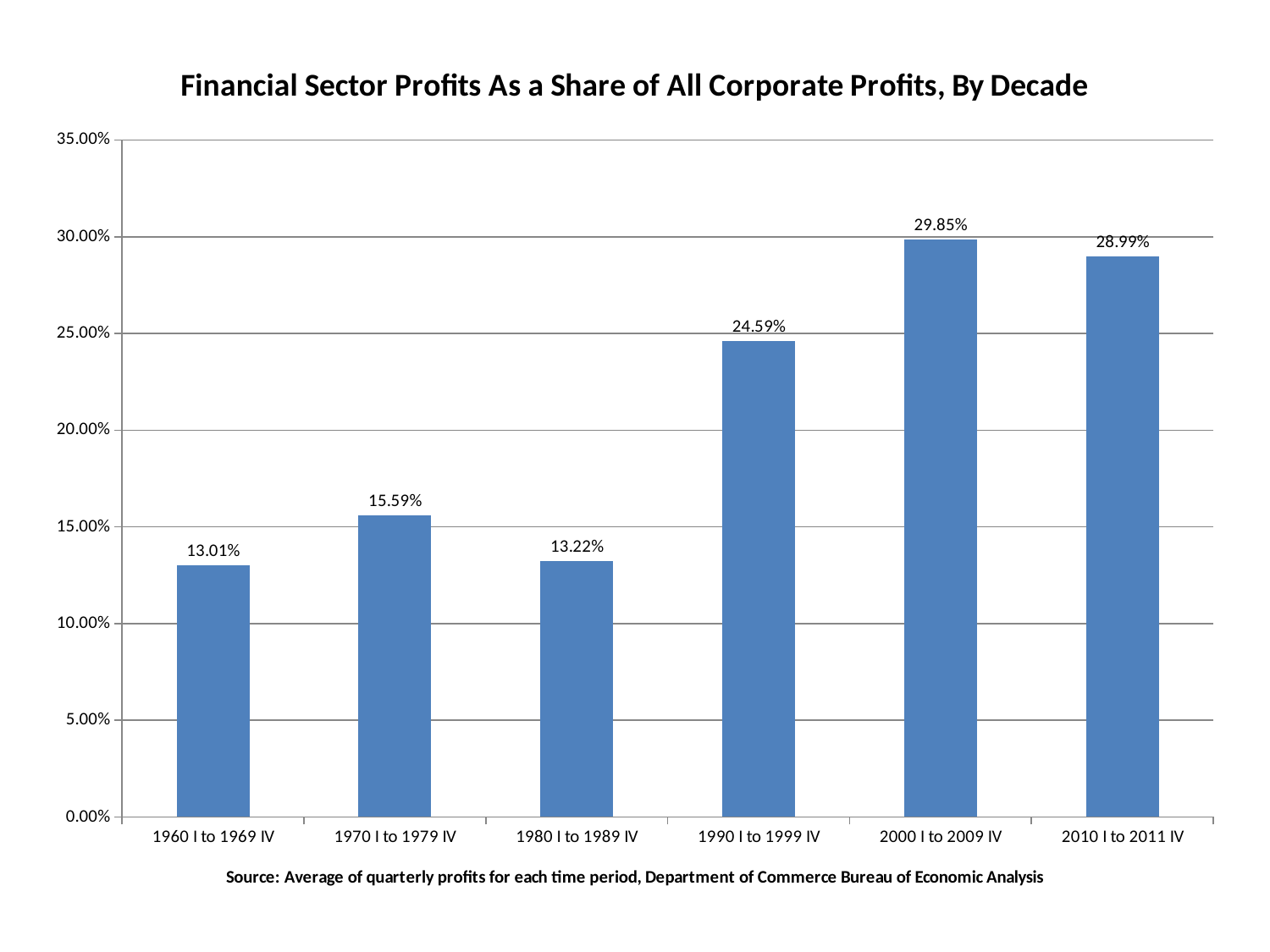
Which period has the highest value? 2000 I to 2009 IV Which period has the lowest value? 1960 I to 1969 IV What is the value for 1960 I to 1969 IV? 13.01% What is the difference between the values for 2000 I to 2009 IV and 2010 I to 2011 IV? 0.86% What is the value for 1990 I to 1999 IV? 24.59% What is the difference between the values for 1990 I to 1999 IV and 1980 I to 1989 IV? 11.37% What is the title of the chart? Financial Sector Profits As a Share of All Corporate Profits, By Decade Is the value for 2010 I to 2011 IV greater or less than 30.00%? less How many periods are shown on the chart? 6 Which is larger, the value for 1970 I to 1979 IV or the value for 1980 I to 1989 IV? 1970 I to 1979 IV What kind of chart is shown on the slide? bar chart What is the value for 2000 I to 2009 IV? 29.85%